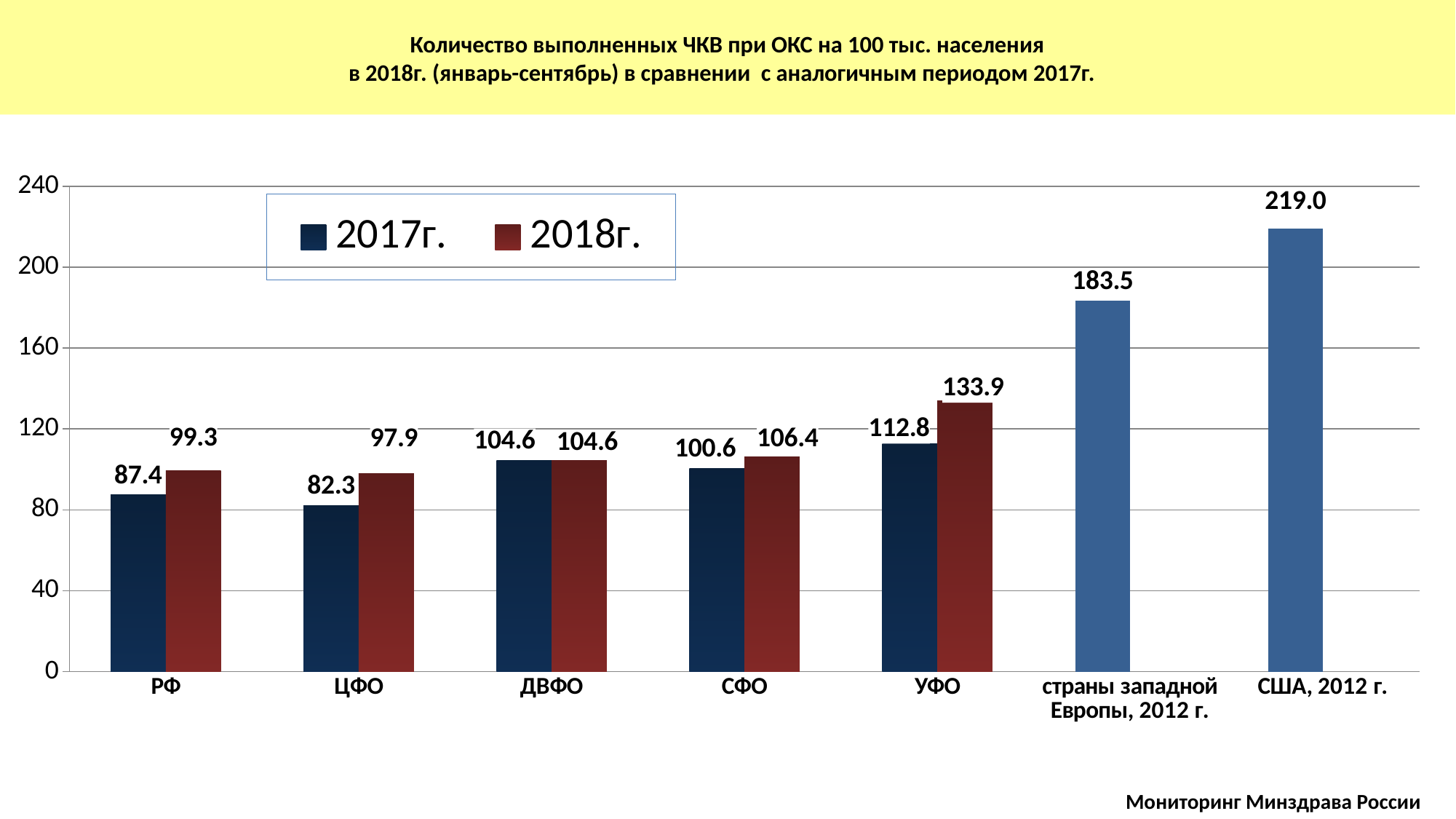
Is the 2018г. value for УФО greater or less than 120? greater Which category has the highest value on the chart? США, 2012 г. How many categories are shown on the x axis? 7 What is the value shown for США, 2012 г.? 219.0 What is the value shown for страны западной Европы, 2012 г.? 183.5 Which is larger for СФО: the 2017г. value or the 2018г. value? 2018г. Which category has the lowest value in the 2017г. series? ЦФО How many series does the legend list? 2 What is the value for ЦФО in the 2017г. series? 82.3 What kind of chart is shown on the slide? bar chart What is the difference between the 2018г. and 2017г. values for УФО? 21.1 What is the value for РФ in the 2018г. series? 99.3